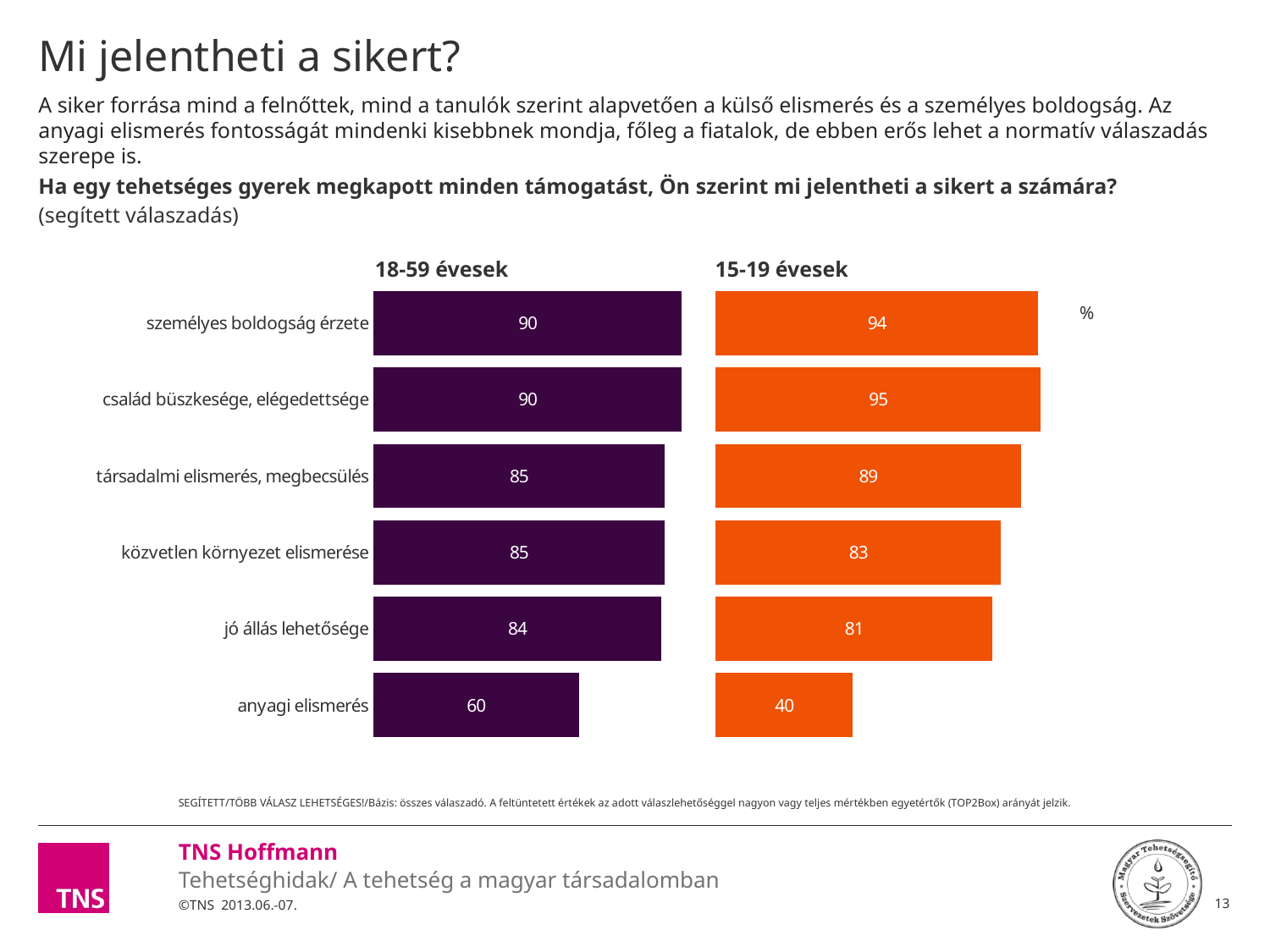
In the 15-19 évesek chart, what is the value for család büszkesége, elégedettsége? 95 What is the difference between the 18-59 évesek and 15-19 évesek values for anyagi elismerés? 20 In the 18-59 évesek chart, what is the value for anyagi elismerés? 60 What type of chart is used for the 15-19 évesek data? bar chart For közvetlen környezet elismerése, which group has the larger value, 18-59 évesek or 15-19 évesek? 18-59 évesek What unit symbol is shown next to the 15-19 évesek chart? % In the 15-19 évesek chart, what is the value for jó állás lehetősége? 81 What colour are the bars in the 18-59 évesek chart? purple How many categories are shown in the 18-59 évesek chart? 6 In the 15-19 évesek chart, which category has the highest value? család büszkesége, elégedettsége In the 15-19 évesek chart, what is the difference between személyes boldogság érzete and jó állás lehetősége? 13 In the 18-59 évesek chart, which category has the lowest value? anyagi elismerés